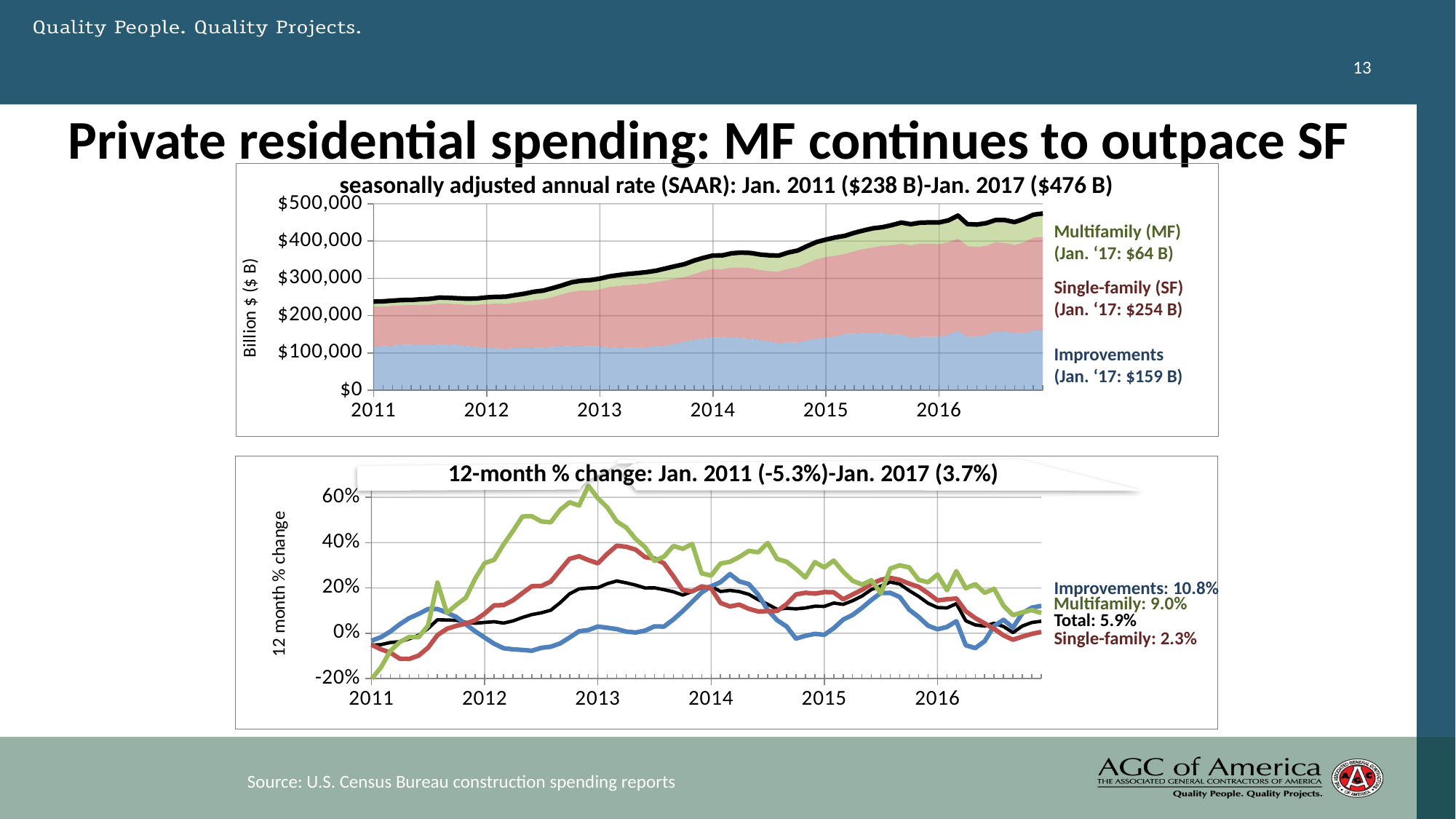
In the bottom chart (12-month % change), what is the latest value for Improvements? 10.8% In the top chart (seasonally adjusted annual rate), what is the Improvements value for Jan. '17? $159 B In the top chart (seasonally adjusted annual rate), does the total spending line generally rise or fall from 2011 to 2017? Rise In the bottom chart (12-month % change), what is the latest value for Single-family? 2.3% In the top chart (seasonally adjusted annual rate), which component has the largest value in Jan. '17? Single-family (SF) In the top chart (seasonally adjusted annual rate), how much larger is the Single-family value than the Multifamily value for Jan. '17? $190 B In the top chart (seasonally adjusted annual rate), what is the total value for Jan. 2017 given in the chart title? $476 B How many series are labelled in the bottom chart (12-month % change)? 4 In the top chart (seasonally adjusted annual rate), what is the Single-family (SF) value for Jan. '17? $254 B What kind of chart is the top chart (seasonally adjusted annual rate)? Stacked area chart In the top chart (seasonally adjusted annual rate), what is the Multifamily (MF) value for Jan. '17? $64 B In the bottom chart (12-month % change), which is larger at the latest point: Multifamily or Total? Multifamily